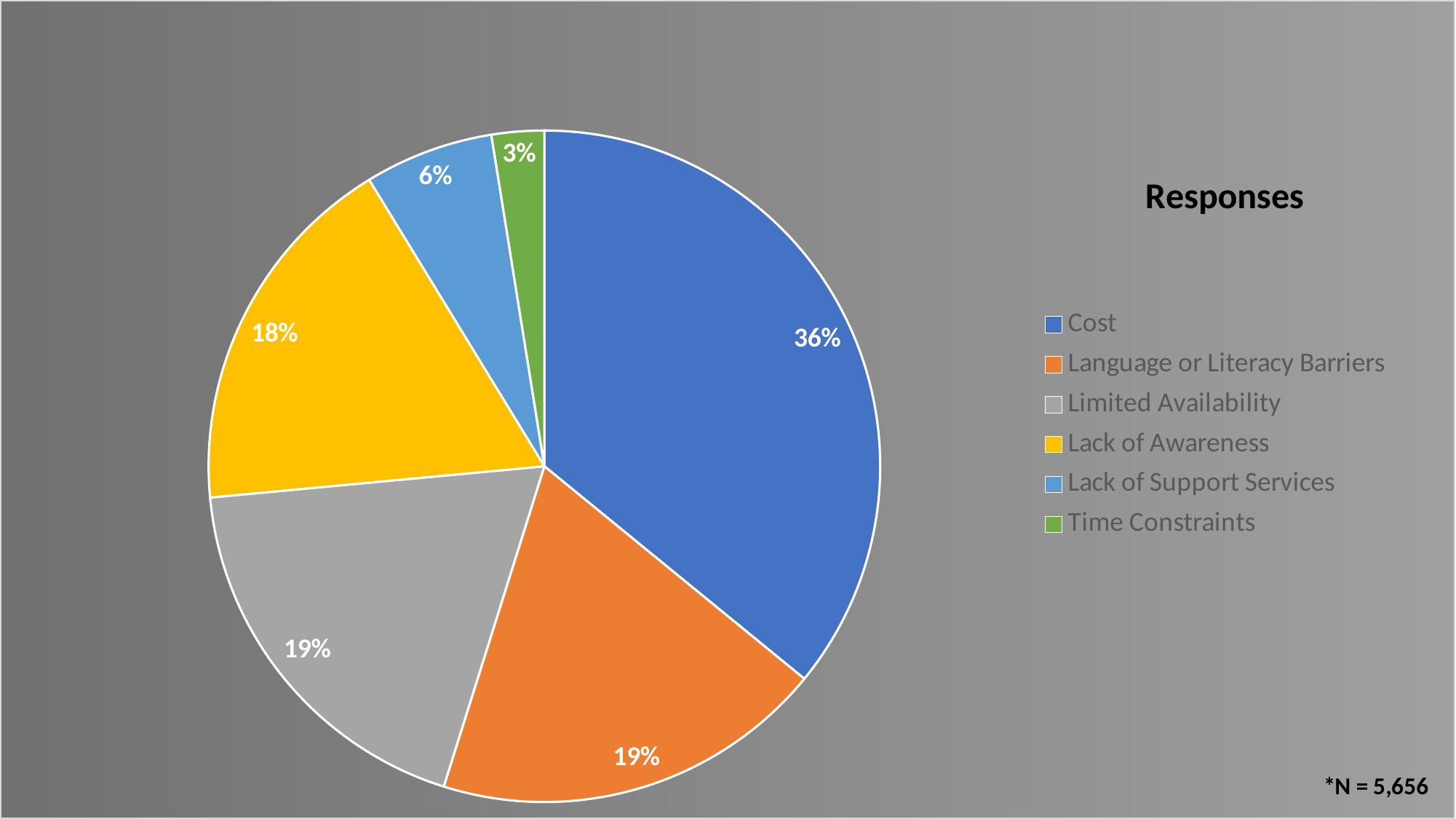
How many categories does the pie chart show? 6 What is the difference in percentage points between Cost and Lack of Awareness? 18 Which category has the smallest slice of the pie? Time Constraints Which category has the largest slice of the pie? Cost What is the sample size N noted on the slide? 5,656 What share of responses does Cost account for? 36% What share of responses does Time Constraints account for? 3% What is the title of the chart? Responses What kind of chart is shown on the slide? Pie chart Which is larger, the share for Lack of Support Services or the share for Time Constraints? Lack of Support Services What share of responses does Lack of Awareness account for? 18%